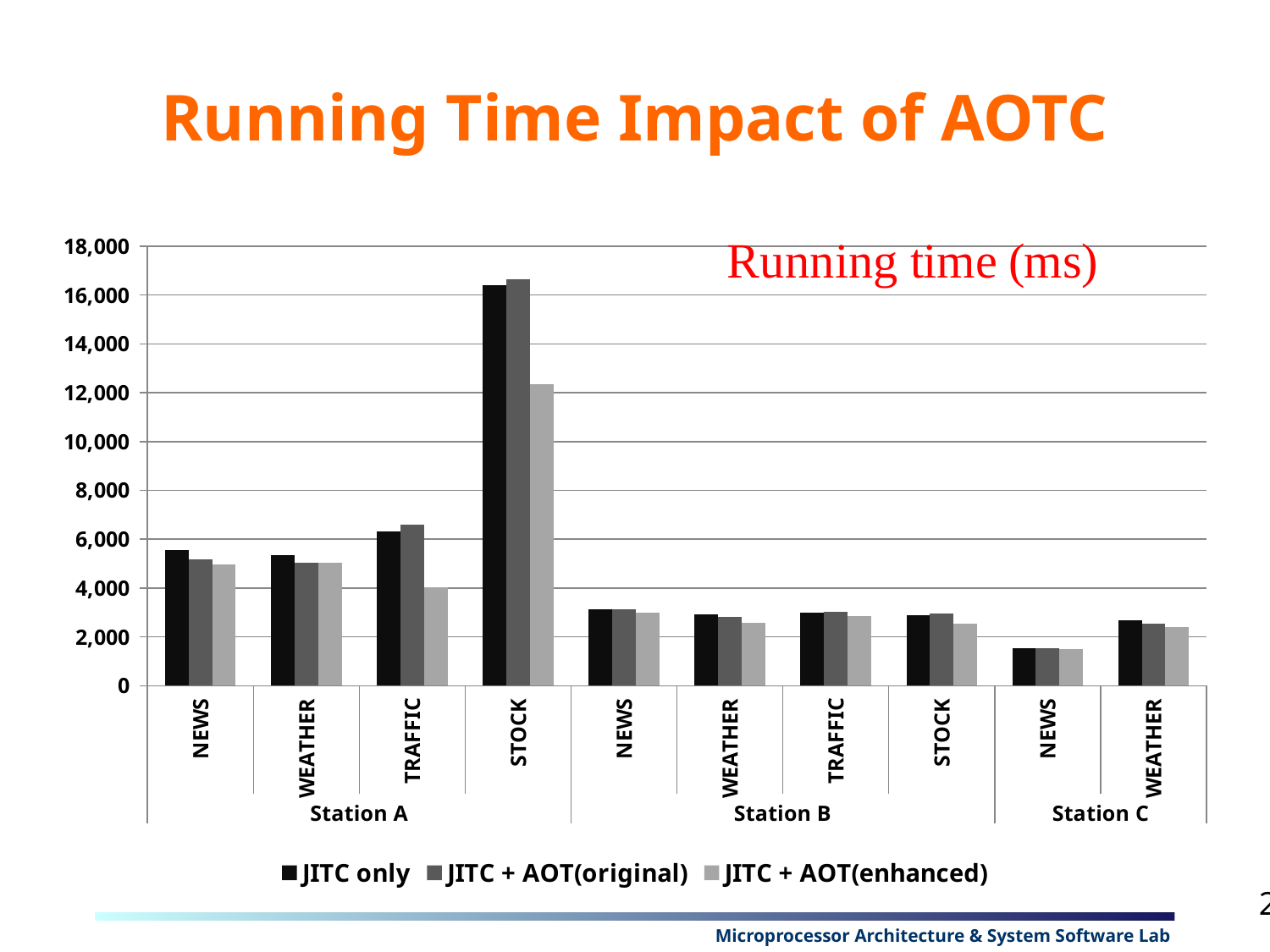
How many program categories are plotted along the x axis across all stations? 10 Is the JITC + AOT(enhanced) value for Station A STOCK greater or less than 14,000? less Is the JITC only value for Station A STOCK greater or less than 14,000? greater For the JITC only series, which is larger: Station A NEWS or Station B NEWS? Station A NEWS What kind of chart is shown on the slide? bar chart What unit is given in the chart's title for running time? ms Is the JITC only value for Station C NEWS greater or less than 2,000? less Which category has the lowest running time in the chart? Station C NEWS Which category has the highest running time in the chart? Station A STOCK For Station A TRAFFIC, which is larger: the JITC only value or the JITC + AOT(enhanced) value? JITC only How many series does the legend list? 3